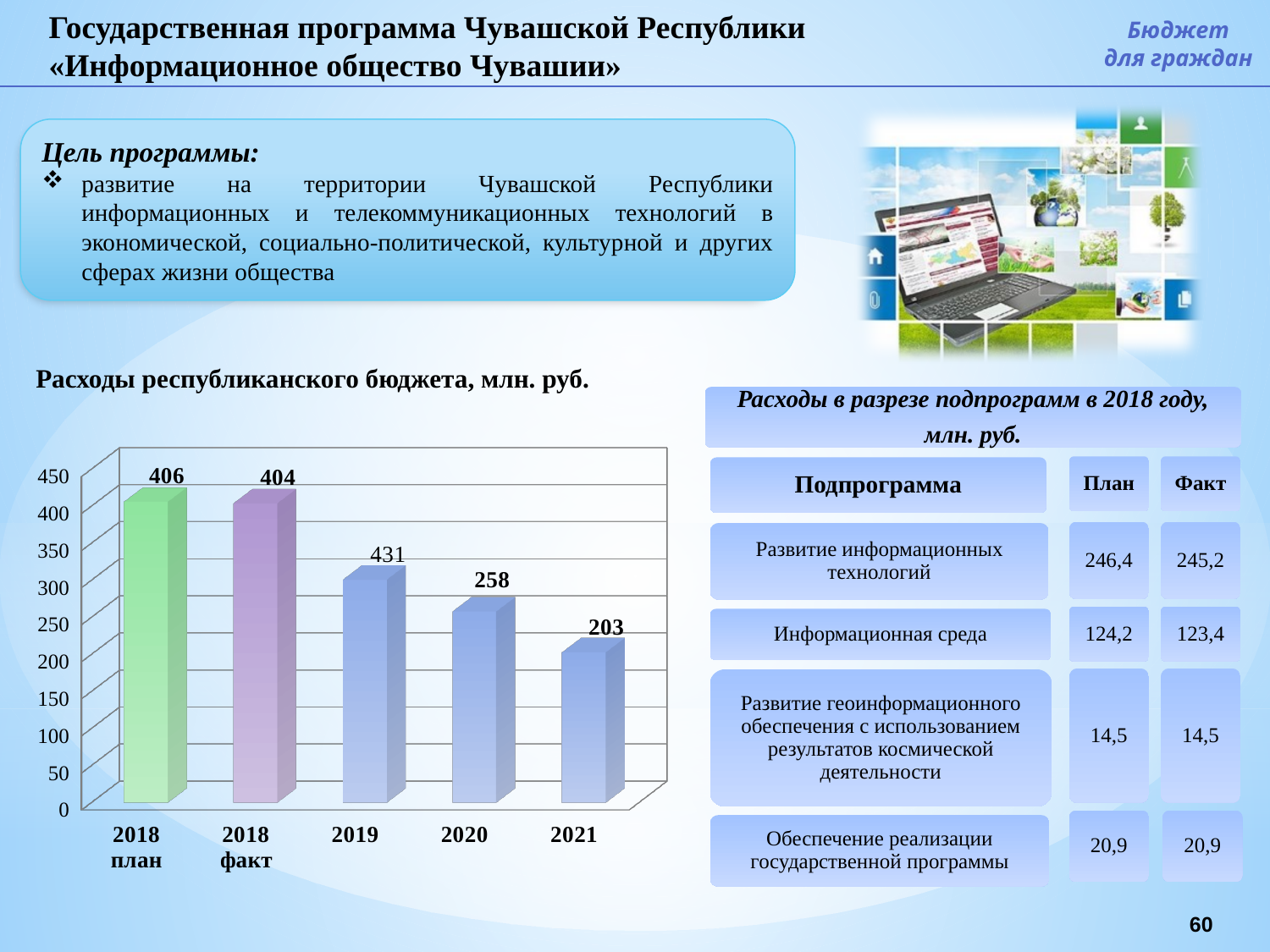
In the chart «Расходы республиканского бюджета, млн. руб.», do the values rise or fall from 2020 to 2021? fall In the chart «Расходы республиканского бюджета, млн. руб.», which category has the lowest value? 2021 In the chart «Расходы республиканского бюджета, млн. руб.», what value is labelled on the 2021 bar? 203 In the chart «Расходы республиканского бюджета, млн. руб.», what is the value for «2018 факт»? 404 In the chart «Расходы республиканского бюджета, млн. руб.», what is the difference between the values for «2018 план» and «2018 факт»? 2 In the chart «Расходы республиканского бюджета, млн. руб.», is the value for 2021 greater or less than 250? less In the chart «Расходы республиканского бюджета, млн. руб.», what is the value for «2018 план»? 406 In the chart «Расходы республиканского бюджета, млн. руб.», which is larger: the value for 2020 or for 2021? 2020 What type of chart is shown under the heading «Расходы республиканского бюджета, млн. руб.»? bar chart How many bars are plotted in the chart «Расходы республиканского бюджета, млн. руб.»? 5 In the chart «Расходы республиканского бюджета, млн. руб.», what is the difference between the 2020 and 2021 values? 55 In the chart «Расходы республиканского бюджета, млн. руб.», what value is labelled on the 2020 bar? 258